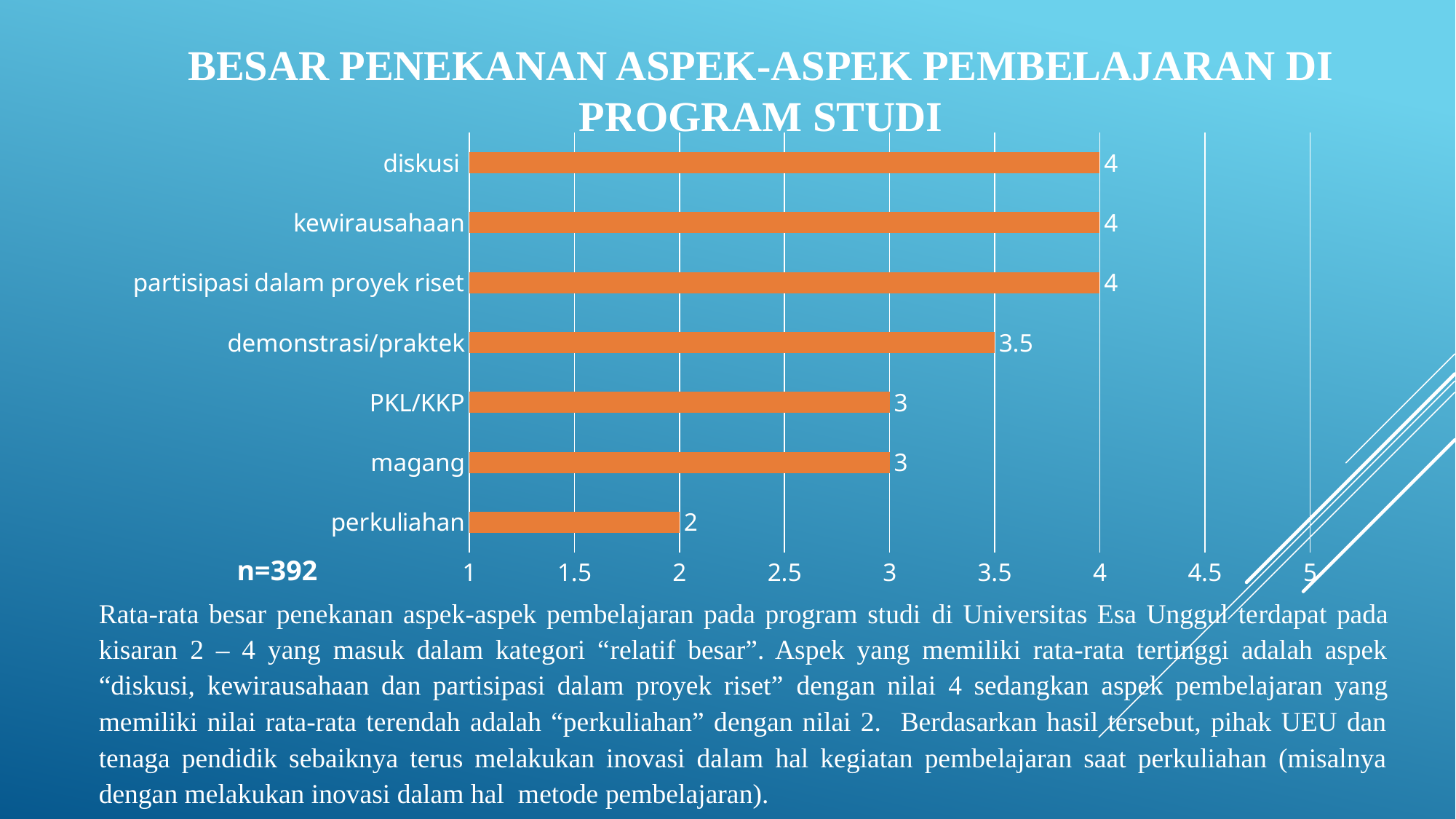
What kind of chart is shown on the slide? bar chart Which category has the lowest value? perkuliahan What is the value for magang? 3 How many categories are shown in the chart? 7 What is the value for demonstrasi/praktek? 3.5 What is the value for diskusi? 4 What is the difference between the values for demonstrasi/praktek and PKL/KKP? 0.5 How many categories have a value of 4? 3 What sample size (n) is shown below the chart? n=392 What is the value for perkuliahan? 2 What is the difference between the values for diskusi and perkuliahan? 2 Which is larger, the value for kewirausahaan or the value for magang? kewirausahaan